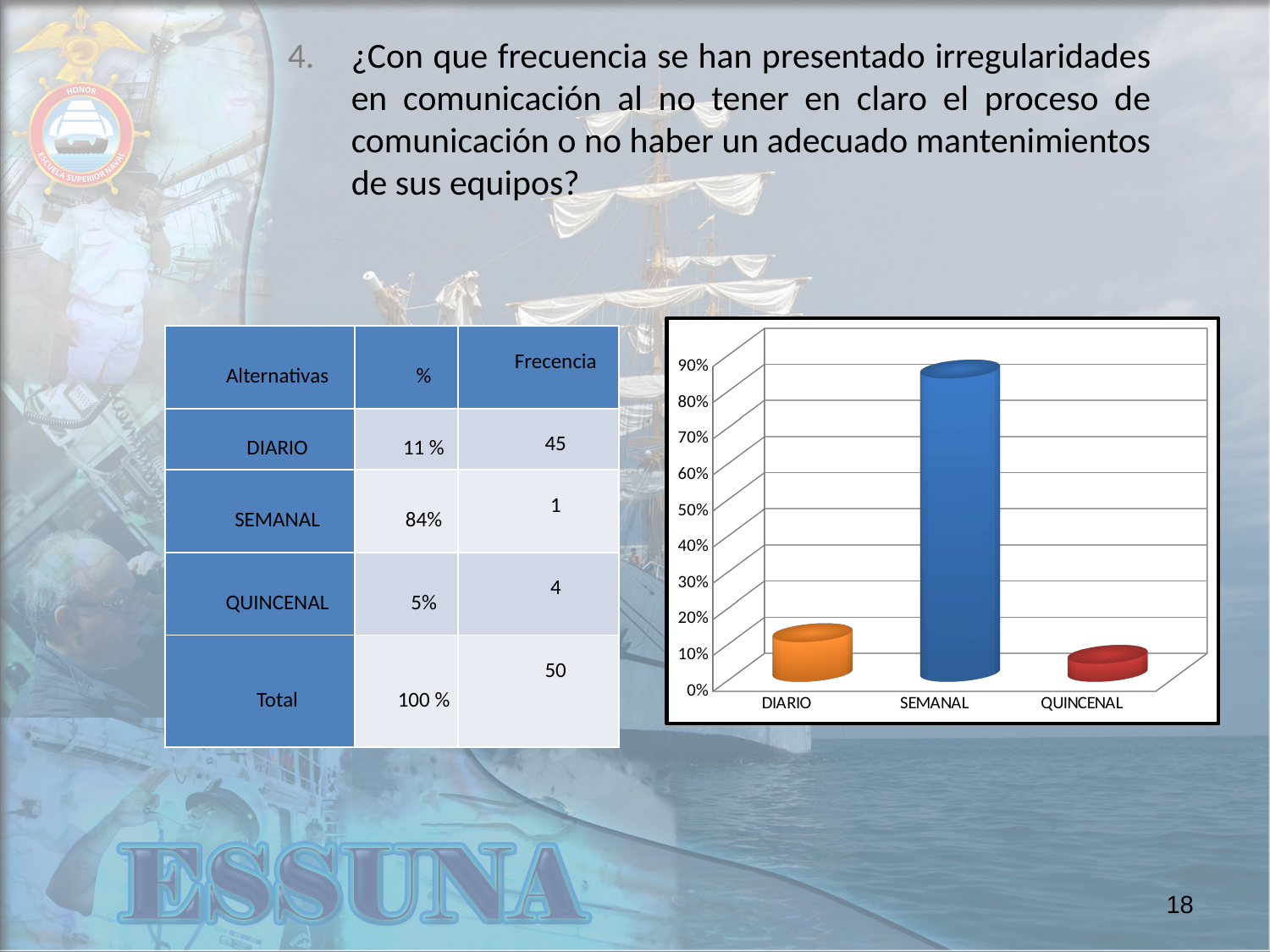
Which category has the lowest bar in the chart? QUINCENAL Is the bar for QUINCENAL greater or less than 10%? less Is the bar for DIARIO greater or less than 20%? less According to the table next to the chart, what percentage corresponds to SEMANAL? 84% How many categories are shown on the x axis of the chart? 3 What colour is the bar for SEMANAL in the chart? blue Which is larger in the chart, the bar for SEMANAL or the bar for DIARIO? SEMANAL What is the highest value labelled on the chart's vertical axis? 90% Is the bar for SEMANAL greater or less than 80%? greater Which category has the highest bar in the chart? SEMANAL Which is larger in the chart, the bar for DIARIO or the bar for QUINCENAL? DIARIO What kind of chart is shown on the slide? bar chart